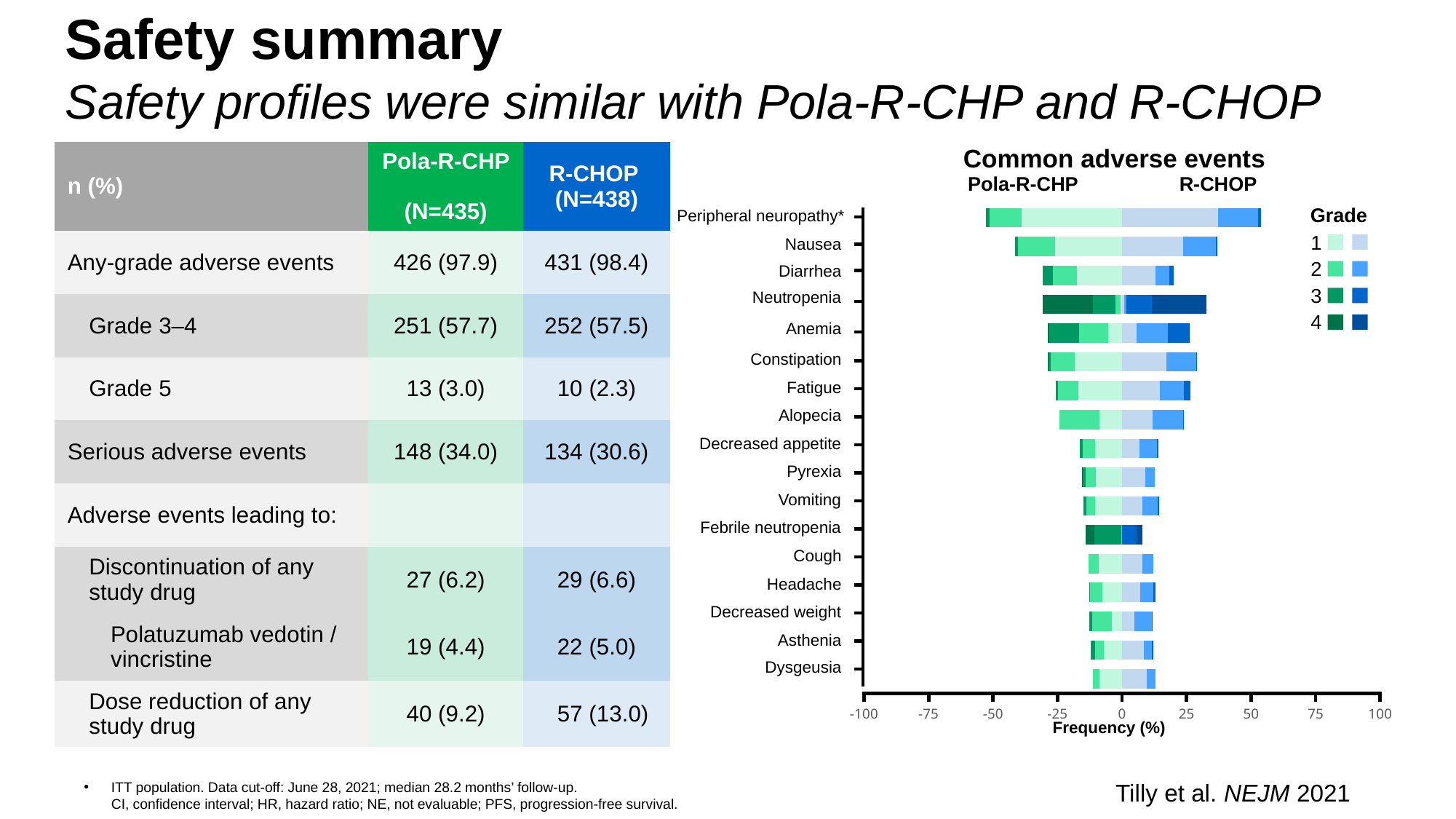
What is the x-axis label of the 'Common adverse events' chart? Frequency (%) In the 'Common adverse events' chart, which adverse event has the highest frequency for R-CHOP? Peripheral neuropathy How many grades does the legend of the 'Common adverse events' chart list? 4 In the 'Common adverse events' chart, which has the larger Pola-R-CHP frequency, Neutropenia or Febrile neutropenia? Neutropenia In the 'Common adverse events' chart, is the R-CHOP frequency for Peripheral neuropathy greater or less than 50? greater What kind of chart is the 'Common adverse events' chart? Bar chart How many adverse event categories are listed on the y axis of the 'Common adverse events' chart? 17 In the 'Common adverse events' chart, is the R-CHOP frequency for Nausea greater or less than 50? less In the 'Common adverse events' chart, is the R-CHOP frequency for Neutropenia greater or less than 25? greater Which two treatment arms are compared in the 'Common adverse events' chart? Pola-R-CHP and R-CHOP In the 'Common adverse events' chart, which has the larger R-CHOP frequency, Peripheral neuropathy or Nausea? Peripheral neuropathy